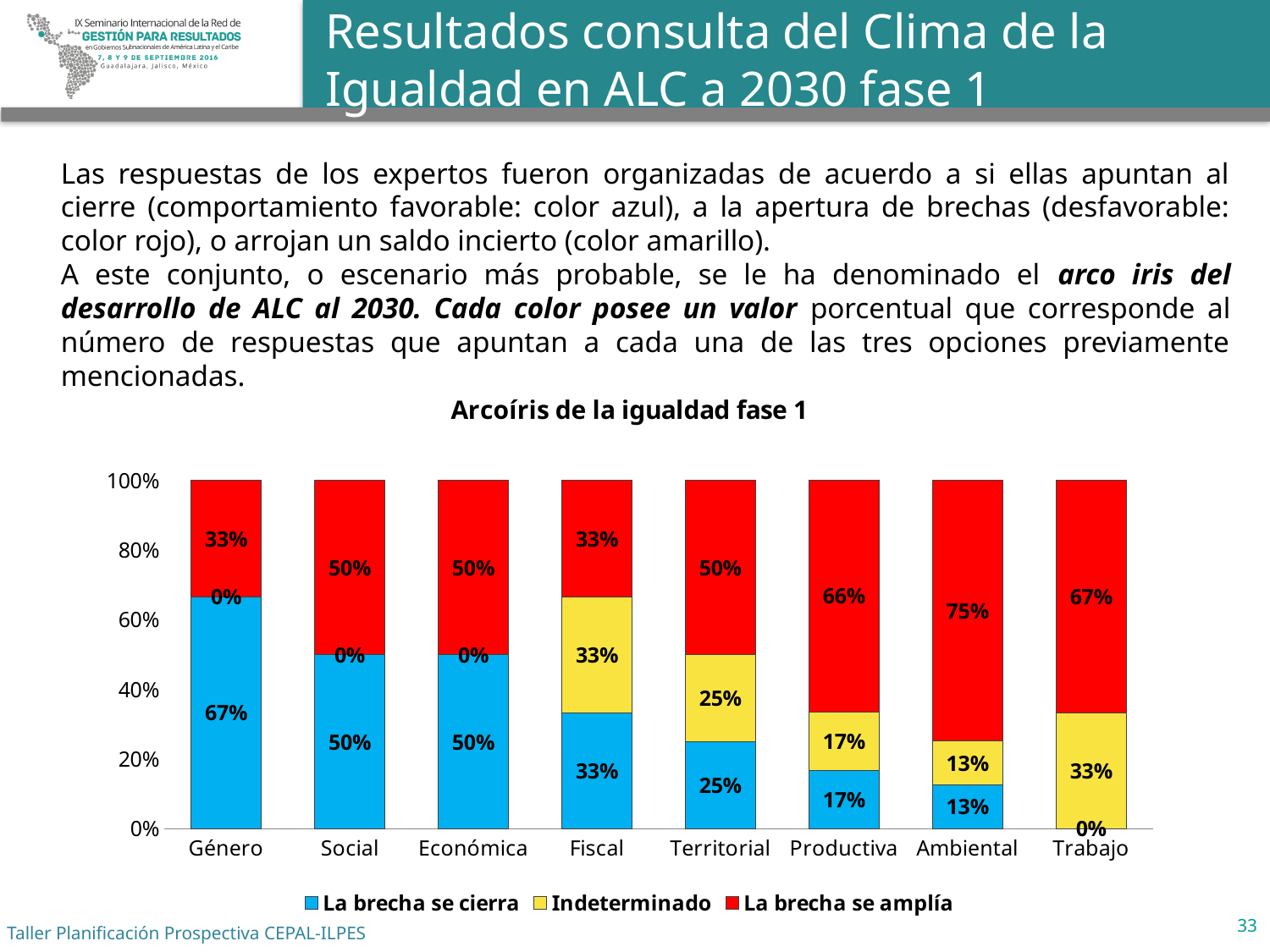
What is the value of 'Indeterminado' for Trabajo? 33% Which category has the highest value for 'La brecha se amplía'? Ambiental What is the value of 'La brecha se amplía' for Ambiental? 75% What is the value of 'La brecha se cierra' for Género? 67% How many series does the legend list? 3 Which category has the lowest value for 'La brecha se cierra'? Trabajo How many categories are shown on the x axis? 8 What is the value of 'La brecha se amplía' for Productiva? 66% What is the difference between the 'La brecha se amplía' values for Trabajo and Género? 34% What type of chart is shown on the slide? Stacked bar chart Which is larger: 'La brecha se cierra' for Territorial or for Productiva? Territorial Which category has the highest value for 'La brecha se cierra'? Género